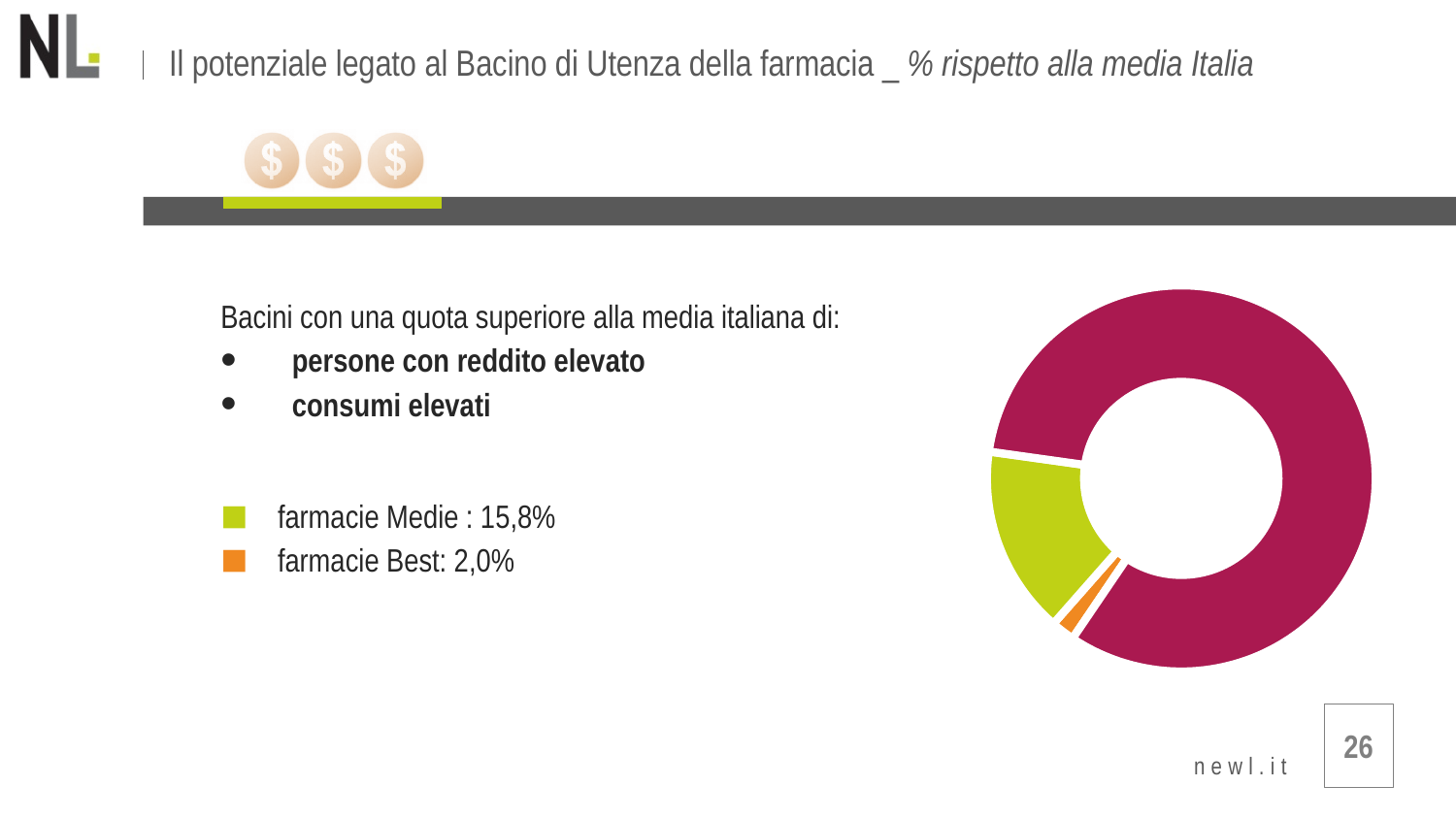
How many entries does the legend list? 2 What is the combined share of farmacie Medie and farmacie Best? 17,8% Is the share for farmacie Medie greater or less than 10%? greater What is the difference between the shares of farmacie Medie and farmacie Best? 13,8% What percentage is shown for farmacie Medie? 15,8% What percentage is shown for farmacie Best? 2,0% What colour represents farmacie Best in the chart? Orange What colour represents farmacie Medie in the chart? Green What kind of chart is shown on the slide? Donut (pie) chart Of the two labelled categories, which has the smaller share? farmacie Best Which has the larger share, farmacie Medie or farmacie Best? farmacie Medie How many slices does the donut chart have? 3